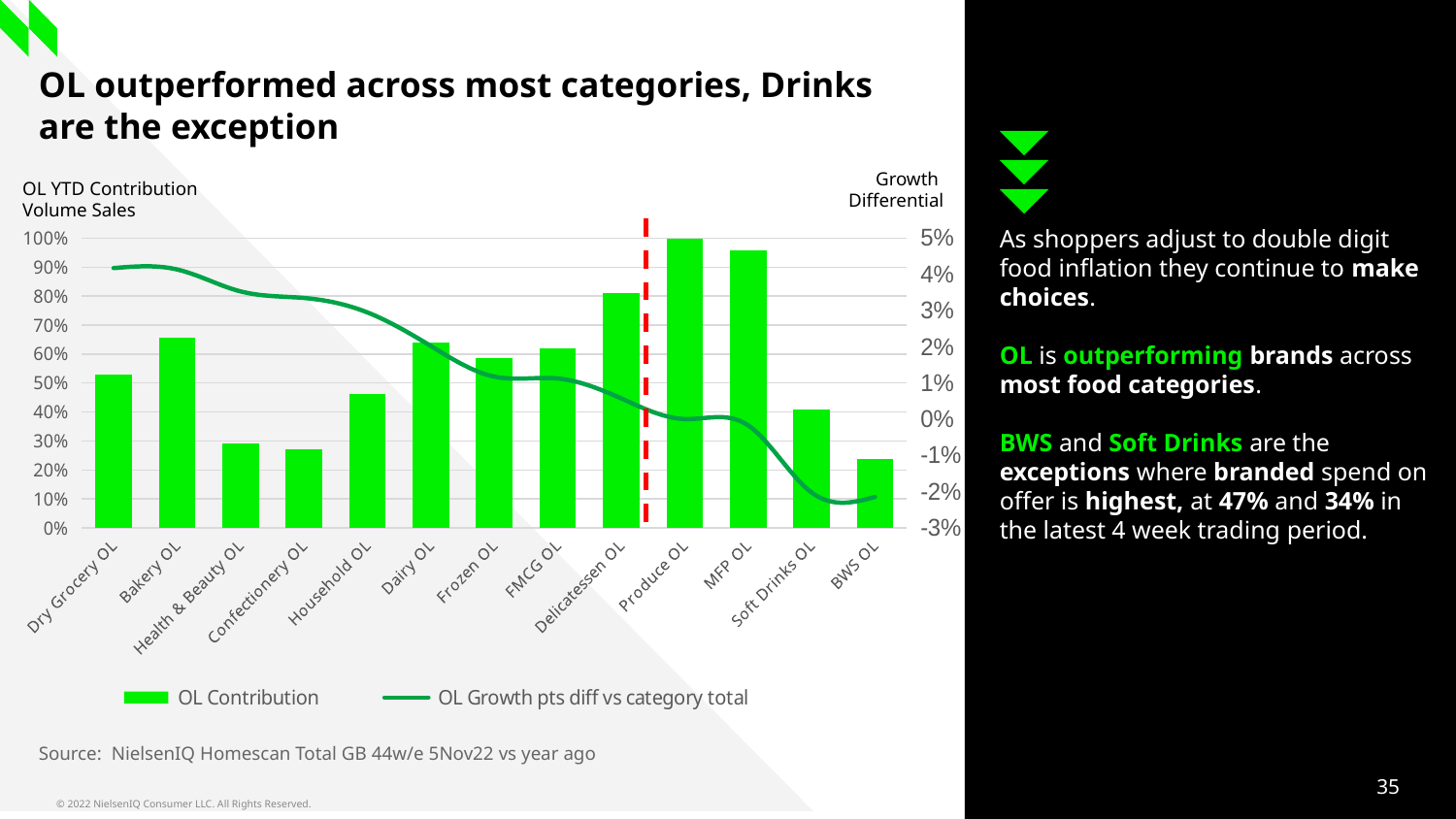
Does the OL Growth pts diff vs category total line generally rise or fall from left to right across the categories? Fall What are the two entries in the chart legend? OL Contribution; OL Growth pts diff vs category total Is the OL Contribution for Household OL greater or less than 50%? less What kind of chart is shown on the slide? A bar chart with a line overlay Is the OL Contribution for BWS OL greater or less than 30%? less How many series does the chart legend list? 2 How many categories are shown on the x axis of the chart? 13 Which category has the highest OL Contribution bar? Produce OL Is the OL Contribution for MFP OL greater or less than 90%? greater Which has a larger OL Contribution, Bakery OL or Dry Grocery OL? Bakery OL